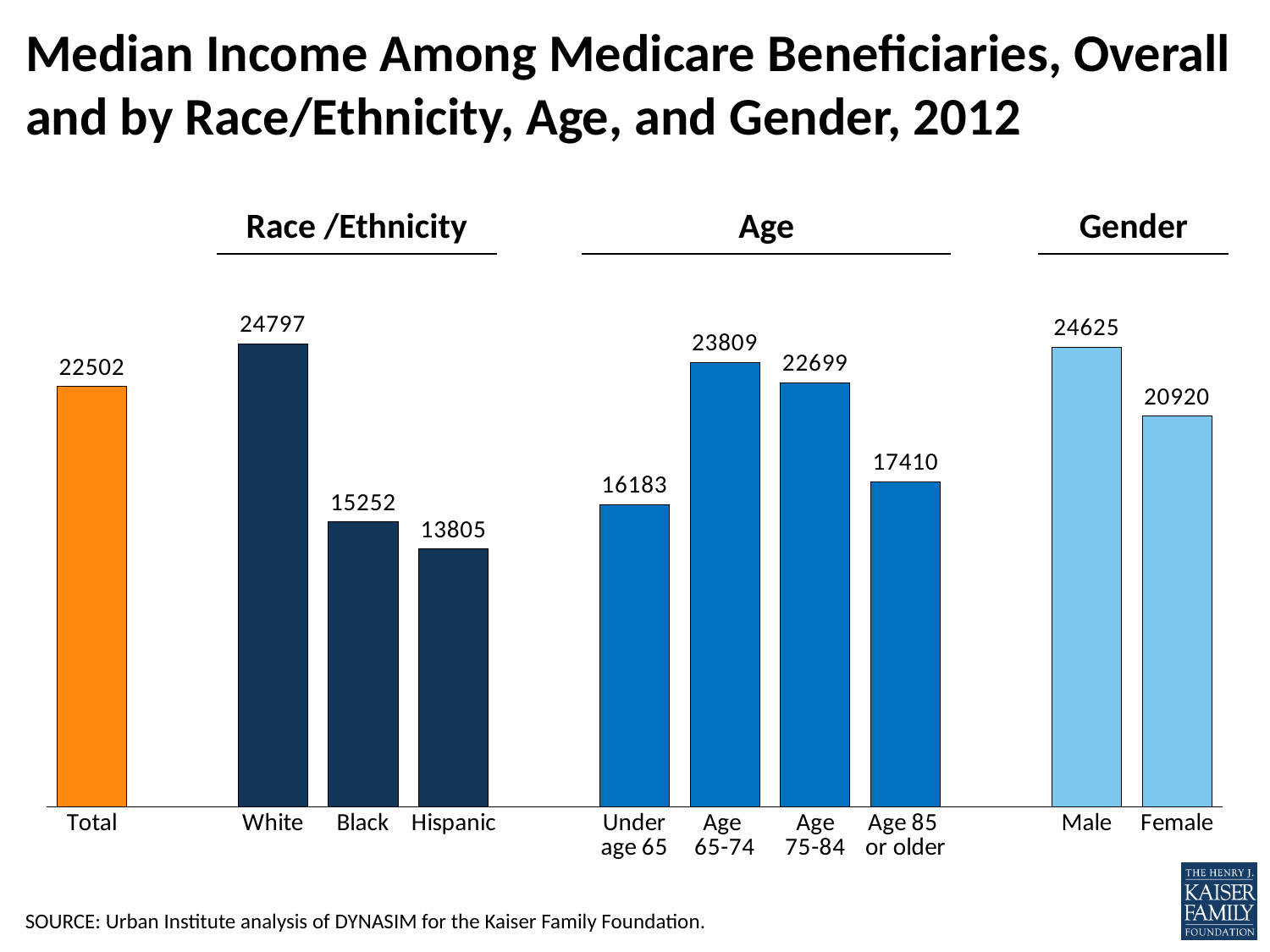
Which is larger, the median income for Age 65-74 or for Age 75-84? Age 65-74 What is the median income for Female beneficiaries? 20920 Which category has the lowest median income? Hispanic Which category has the highest median income? White What is the difference in median income between White and Black beneficiaries? 9545 What is the median income for Hispanic Medicare beneficiaries? 13805 What is the median income for the Total category? 22502 What is the difference in median income between Male and Female beneficiaries? 3705 What kind of chart is shown on the slide? Bar chart How many categories are plotted in the chart? 10 What is the median income for beneficiaries age 85 or older? 17410 What are the three group headings shown above the bars? Race/Ethnicity, Age, Gender